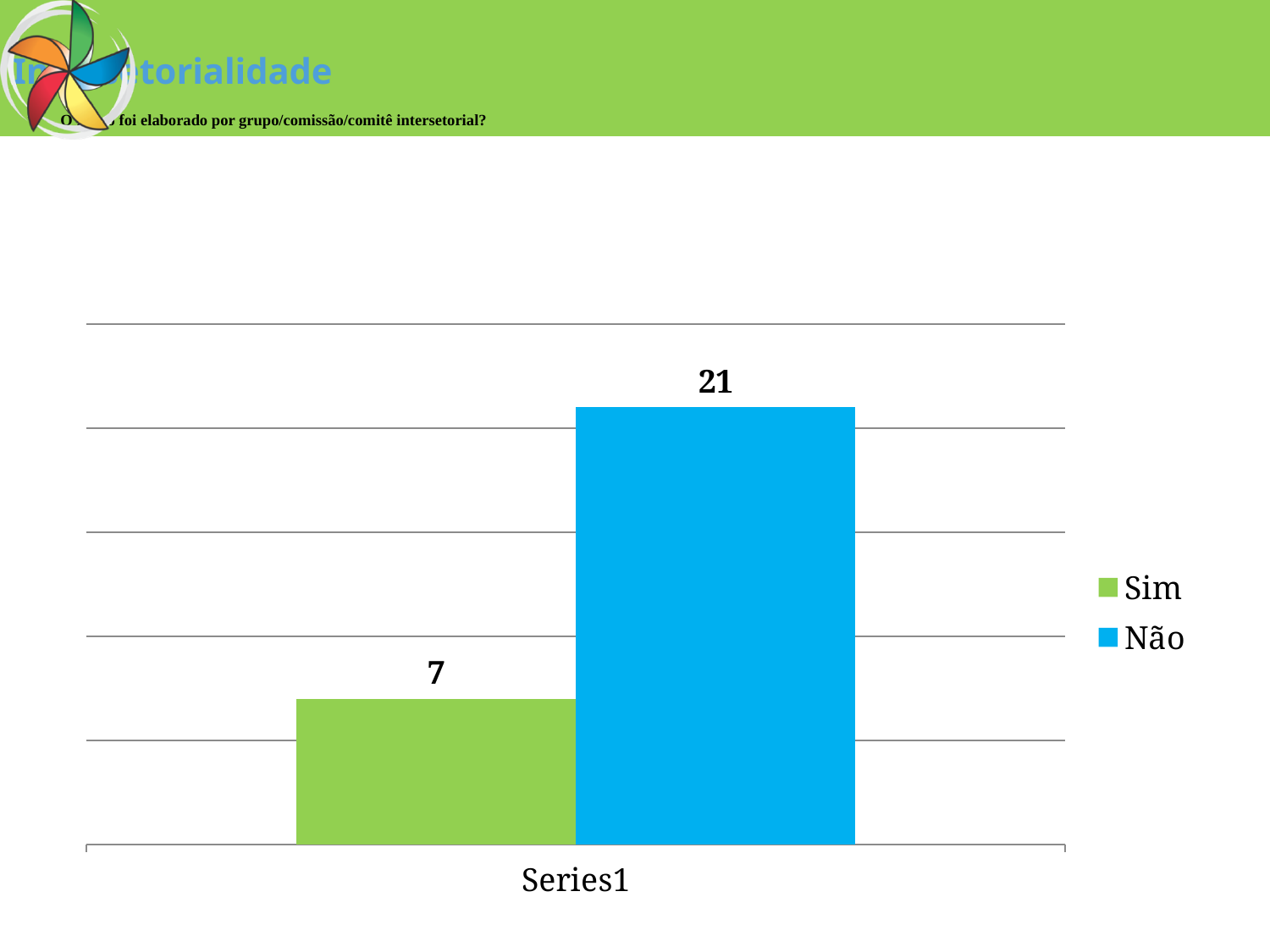
What is the total of the Sim and Não values? 28 What is the category label shown on the x axis? Series1 What kind of chart is shown on the slide? bar chart How many series does the legend list? 2 Which series has the lowest value? Sim What is the value for Não? 21 What colour is the bar for Não? blue Which series has the highest value? Não What is the difference between the values for Não and Sim? 14 Which is larger, the value for Sim or the value for Não? Não What is the value for Sim? 7